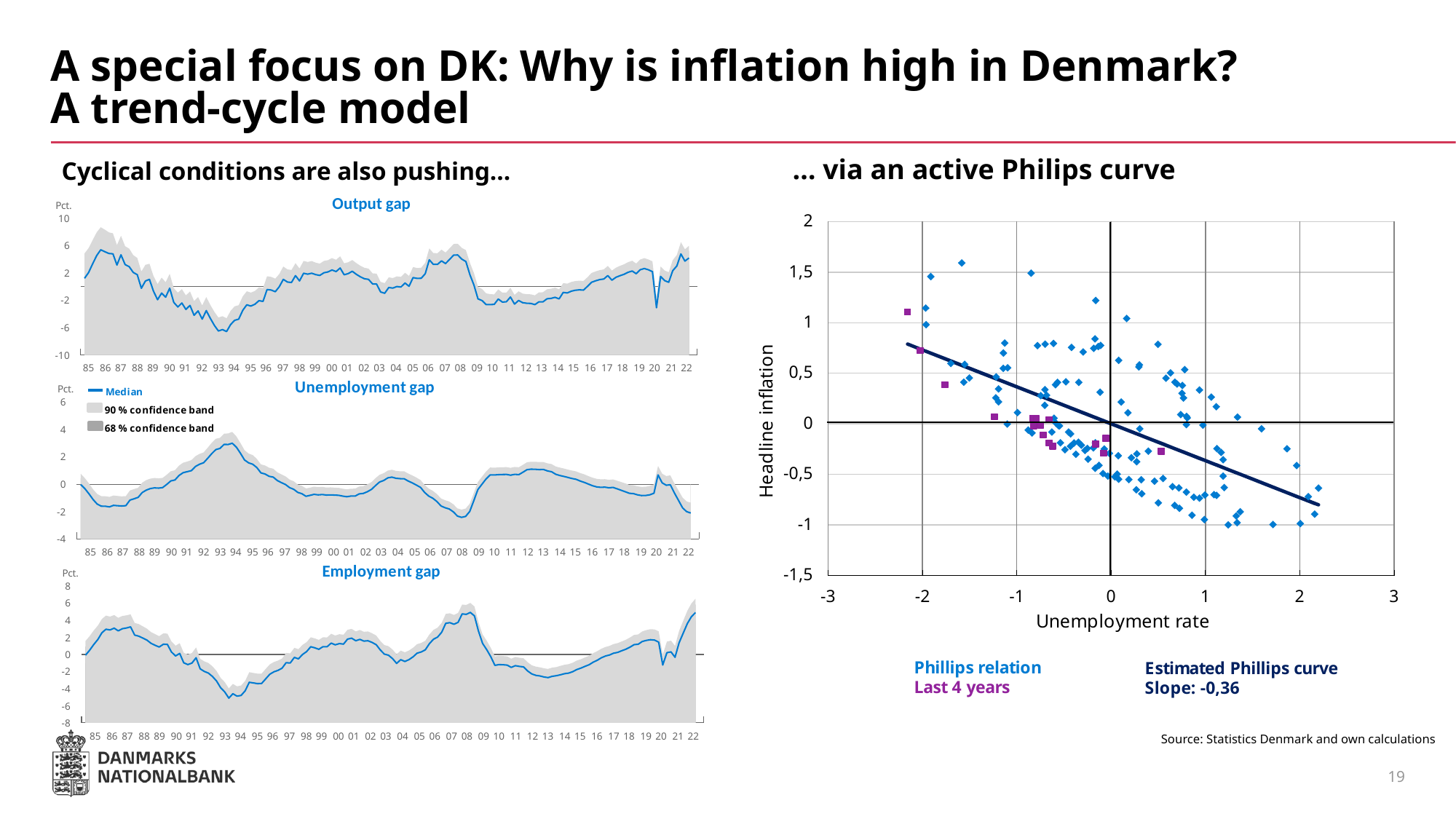
How many entries does the legend of the 'Output gap' chart list? 3 What kind of chart is the chart titled 'Output gap'? line chart What is the label of the vertical axis on the Phillips curve chart? Headline inflation In the 'Employment gap' chart, is the median value in 2008 greater or less than 2? greater In the 'Employment gap' chart, is the median value in 2013 greater or less than 0? less In the 'Output gap' chart, does the median line rise or fall between 2020 and 2022? rise In the 'Unemployment gap' chart, is the median value in 1994 greater or less than 2? greater What kind of chart is the Phillips curve chart on the right of the slide? scatter chart In the 'Unemployment gap' chart, does the median line rise or fall between 2020 and 2022? fall What slope is given for the estimated Phillips curve on the right-hand chart? -0,36 How many charts are shown on the slide? 4